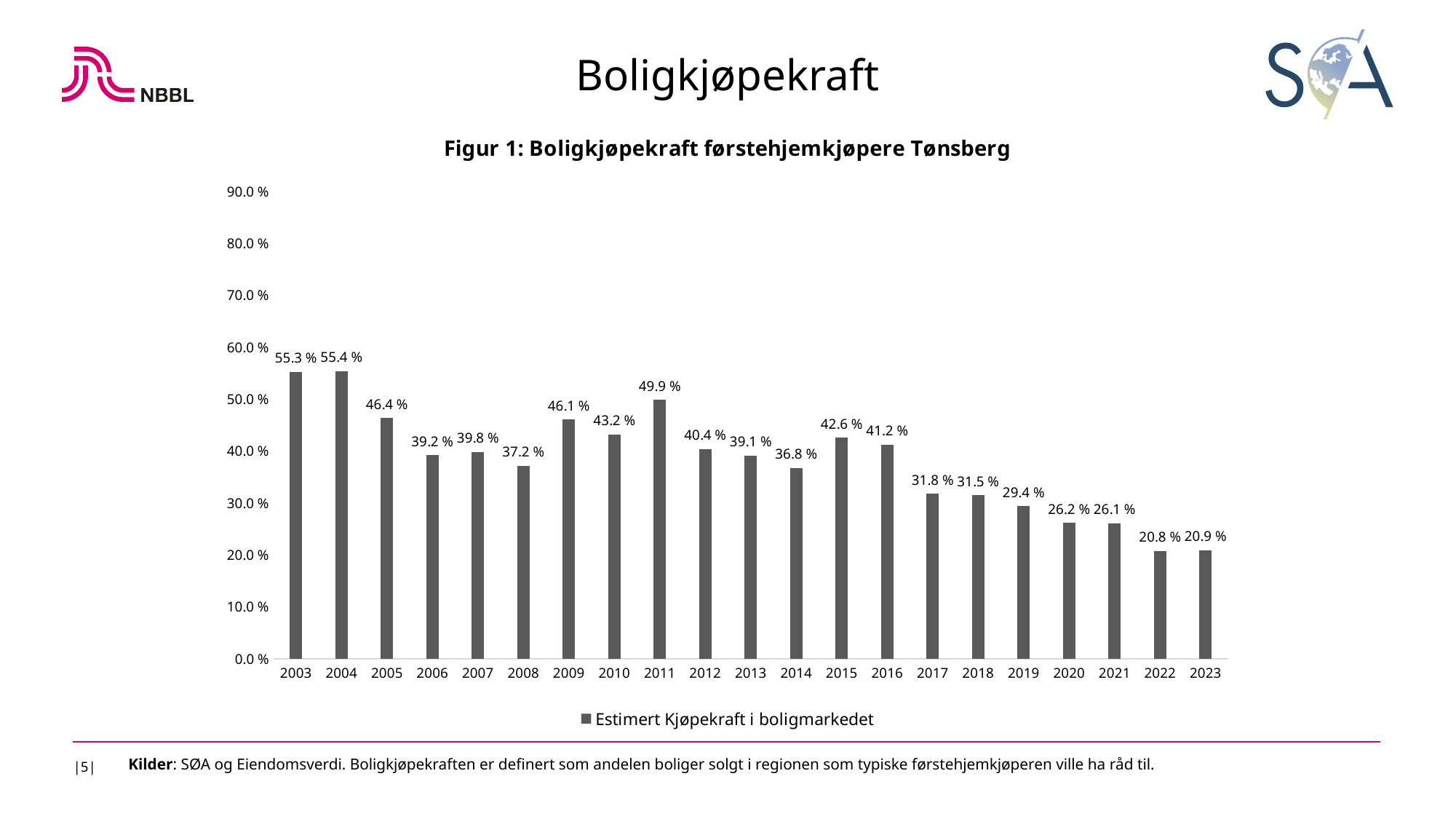
How many years are shown on the x axis? 21 What is the difference between the values for 2003 and 2023? 34.4 % What kind of chart is shown? bar chart What is the value for 2022? 20.8 % What is the value for 2015? 42.6 % Which is larger, the value for 2009 or the value for 2010? 2009 Which year has the lowest value? 2022 How many series does the legend list? 1 Which year has the highest value? 2004 What is the value for 2011? 49.9 % Is the value for 2017 greater or less than 30.0 %? greater What is the title of the chart? Figur 1: Boligkjøpekraft førstehjemkjøpere Tønsberg